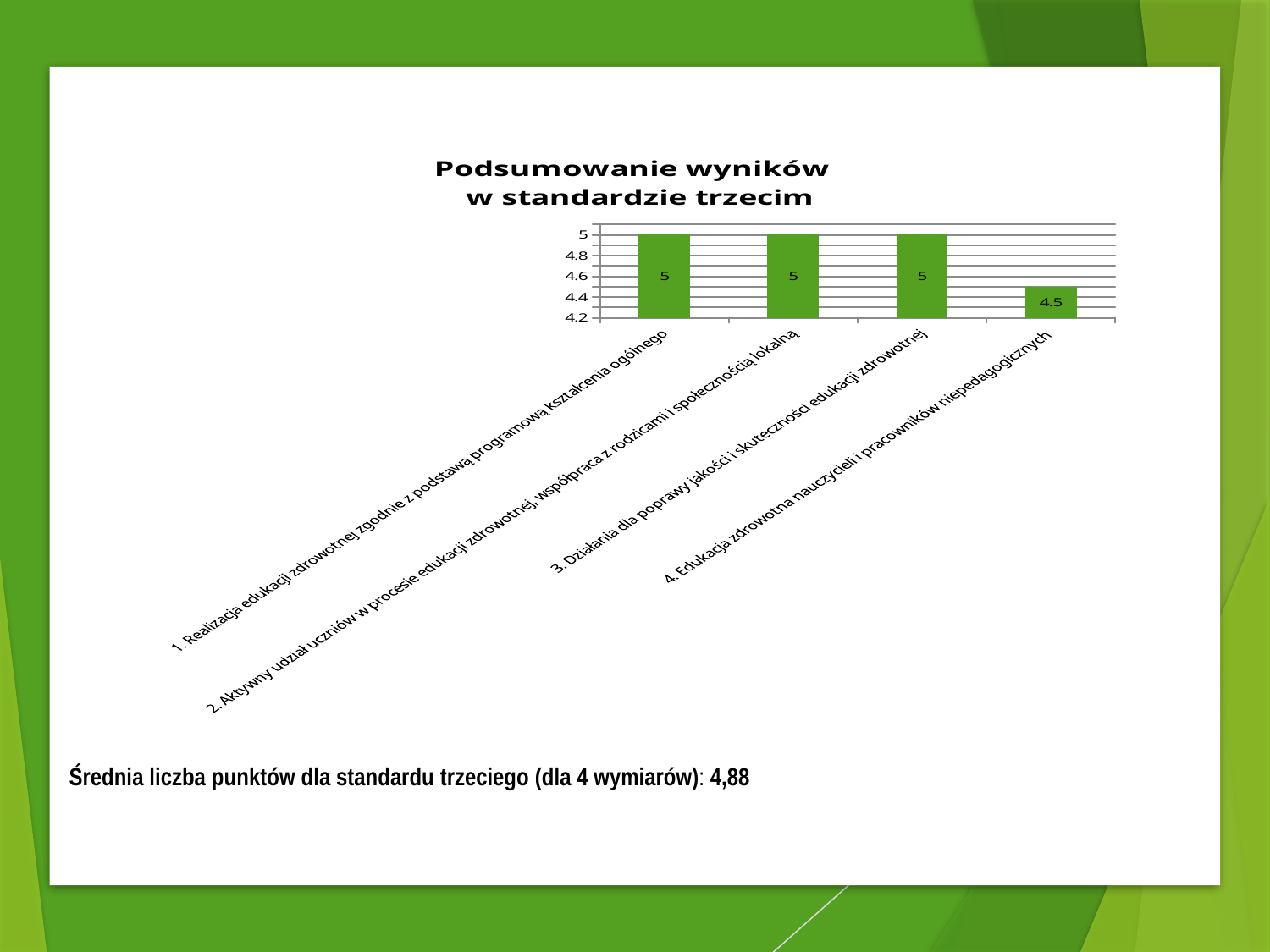
What colour are the bars in the chart? Green Which category has the lowest value? 4. Edukacja zdrowotna nauczycieli i pracowników niepedagogicznych What is the value for category 3, 'Działania dla poprawy jakości i skuteczności edukacji zdrowotnej'? 5 What is the value for category 1, 'Realizacja edukacji zdrowotnej zgodnie z podstawą programową kształcenia ogólnego'? 5 What kind of chart is shown on the slide? Bar chart How many categories have a value of 5? 3 Is the value for category 4 greater or less than 4.6? less Which is larger: the value for category 3 or the value for category 4? Category 3 What is the value for category 4, 'Edukacja zdrowotna nauczycieli i pracowników niepedagogicznych'? 4.5 What is the title of the chart? Podsumowanie wyników w standardzie trzecim How many categories are shown in the chart? 4 What is the difference between the value for category 2 and the value for category 4? 0.5